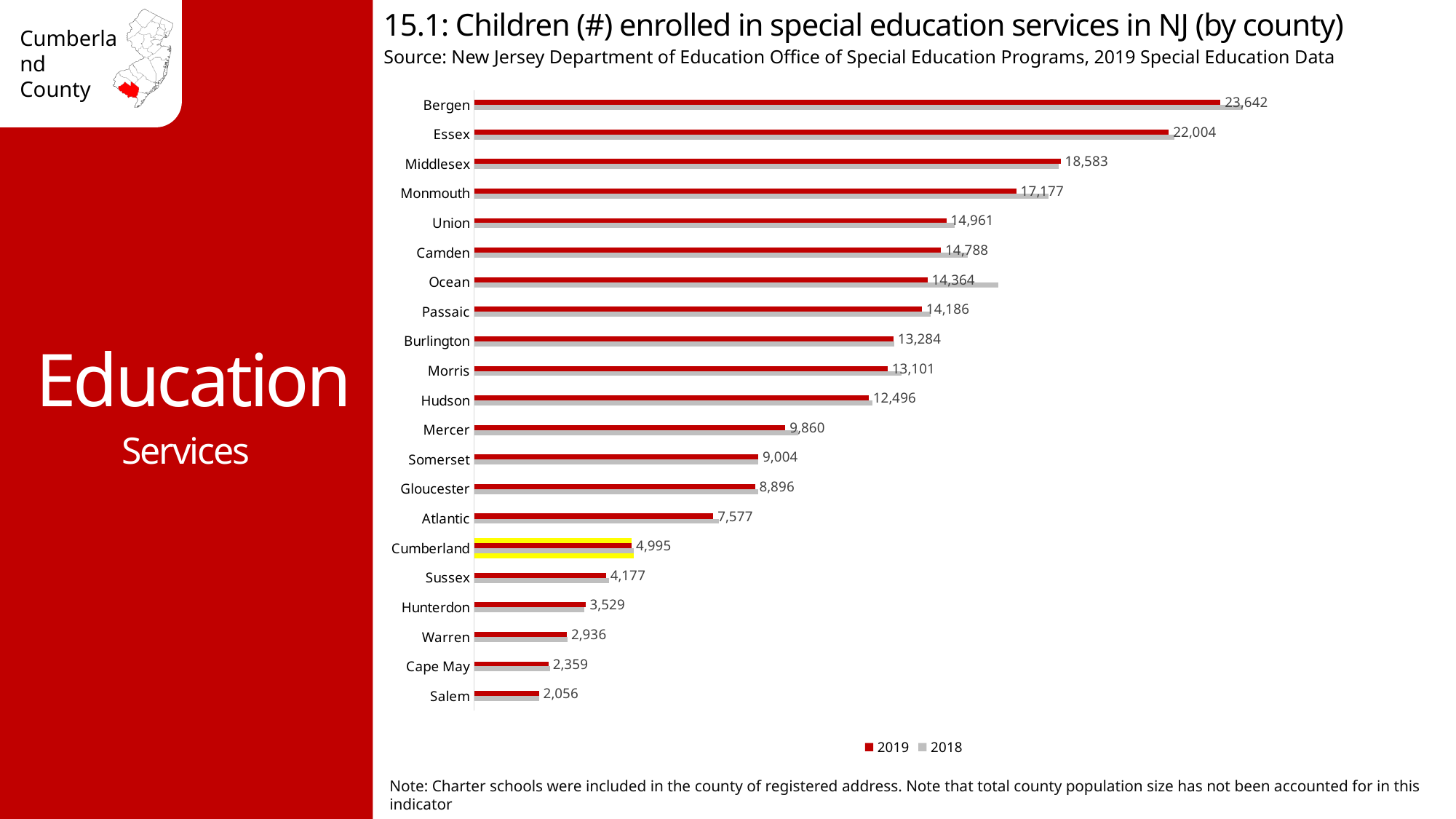
How many series does the legend list? 2 What is the 2019 value for Middlesex? 18,583 What is the 2019 value for Cape May? 2,359 For Ocean, which series has the larger value, 2019 or 2018? 2018 Which county has the lowest 2019 value? Salem Which county has the highest 2019 value? Bergen How many counties are listed in the chart? 21 What kind of chart is shown on the slide? bar chart Which series is shown in red in the legend? 2019 What is the 2019 value for Cumberland? 4,995 What is the difference between the 2019 values for Cumberland and Salem? 2,939 What is the difference between the 2019 values for Bergen and Essex? 1,638